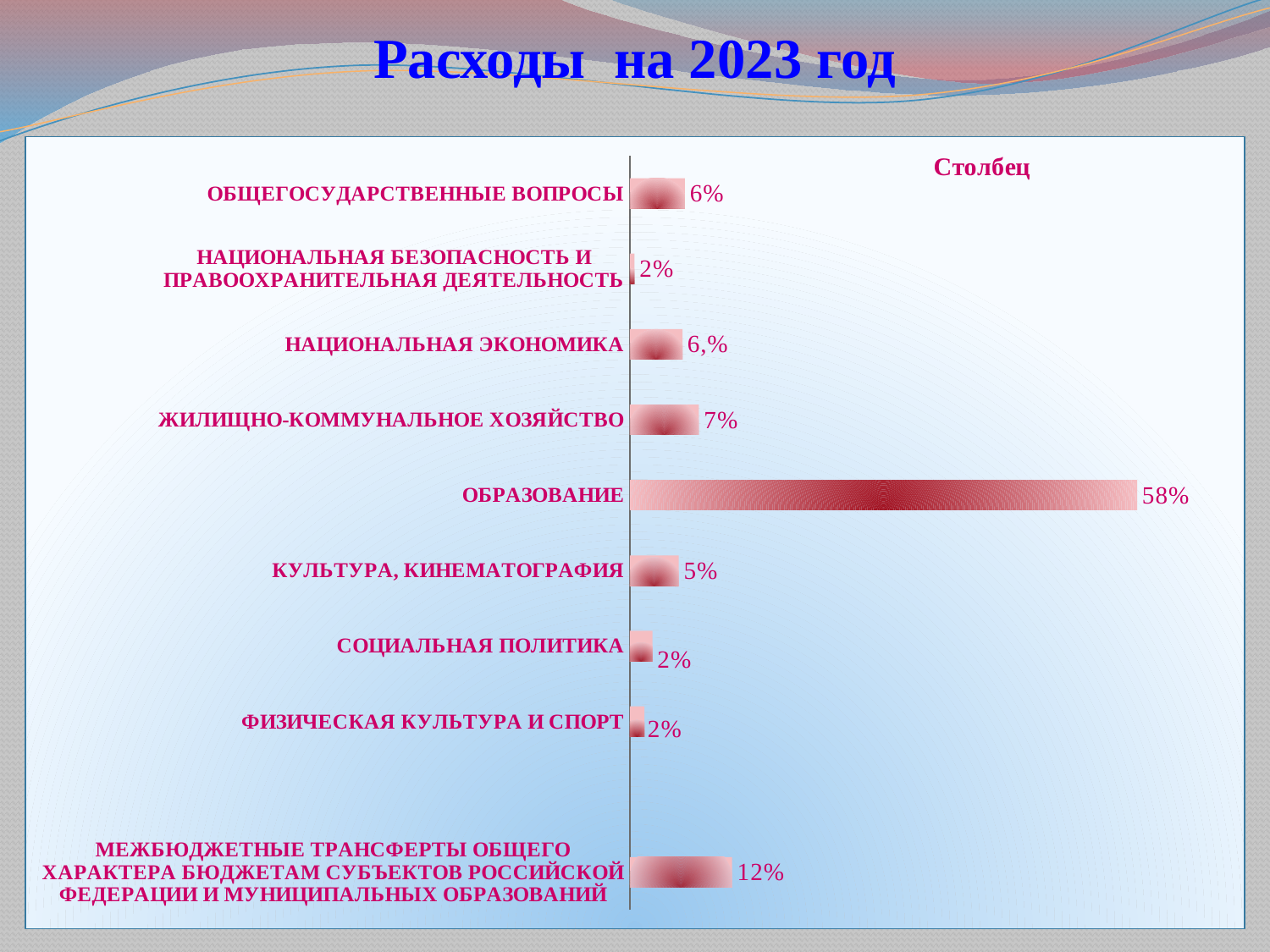
How many categories are shown in the chart? 9 Which is larger, the value for ЖИЛИЩНО-КОММУНАЛЬНОЕ ХОЗЯЙСТВО or the value for КУЛЬТУРА, КИНЕМАТОГРАФИЯ? ЖИЛИЩНО-КОММУНАЛЬНОЕ ХОЗЯЙСТВО What is the value for КУЛЬТУРА, КИНЕМАТОГРАФИЯ? 5% What is the difference between the values for ОБРАЗОВАНИЕ and МЕЖБЮДЖЕТНЫЕ ТРАНСФЕРТЫ ОБЩЕГО ХАРАКТЕРА БЮДЖЕТАМ СУБЪЕКТОВ РОССИЙСКОЙ ФЕДЕРАЦИИ И МУНИЦИПАЛЬНЫХ ОБРАЗОВАНИЙ? 46% Which category has the highest value? ОБРАЗОВАНИЕ What is the value for МЕЖБЮДЖЕТНЫЕ ТРАНСФЕРТЫ ОБЩЕГО ХАРАКТЕРА БЮДЖЕТАМ СУБЪЕКТОВ РОССИЙСКОЙ ФЕДЕРАЦИИ И МУНИЦИПАЛЬНЫХ ОБРАЗОВАНИЙ? 12% What is the value for СОЦИАЛЬНАЯ ПОЛИТИКА? 2% What kind of chart is shown on the slide? Bar chart What is the value for ОБЩЕГОСУДАРСТВЕННЫЕ ВОПРОСЫ? 6% What is the value for ЖИЛИЩНО-КОММУНАЛЬНОЕ ХОЗЯЙСТВО? 7% What is the value for ОБРАЗОВАНИЕ? 58%